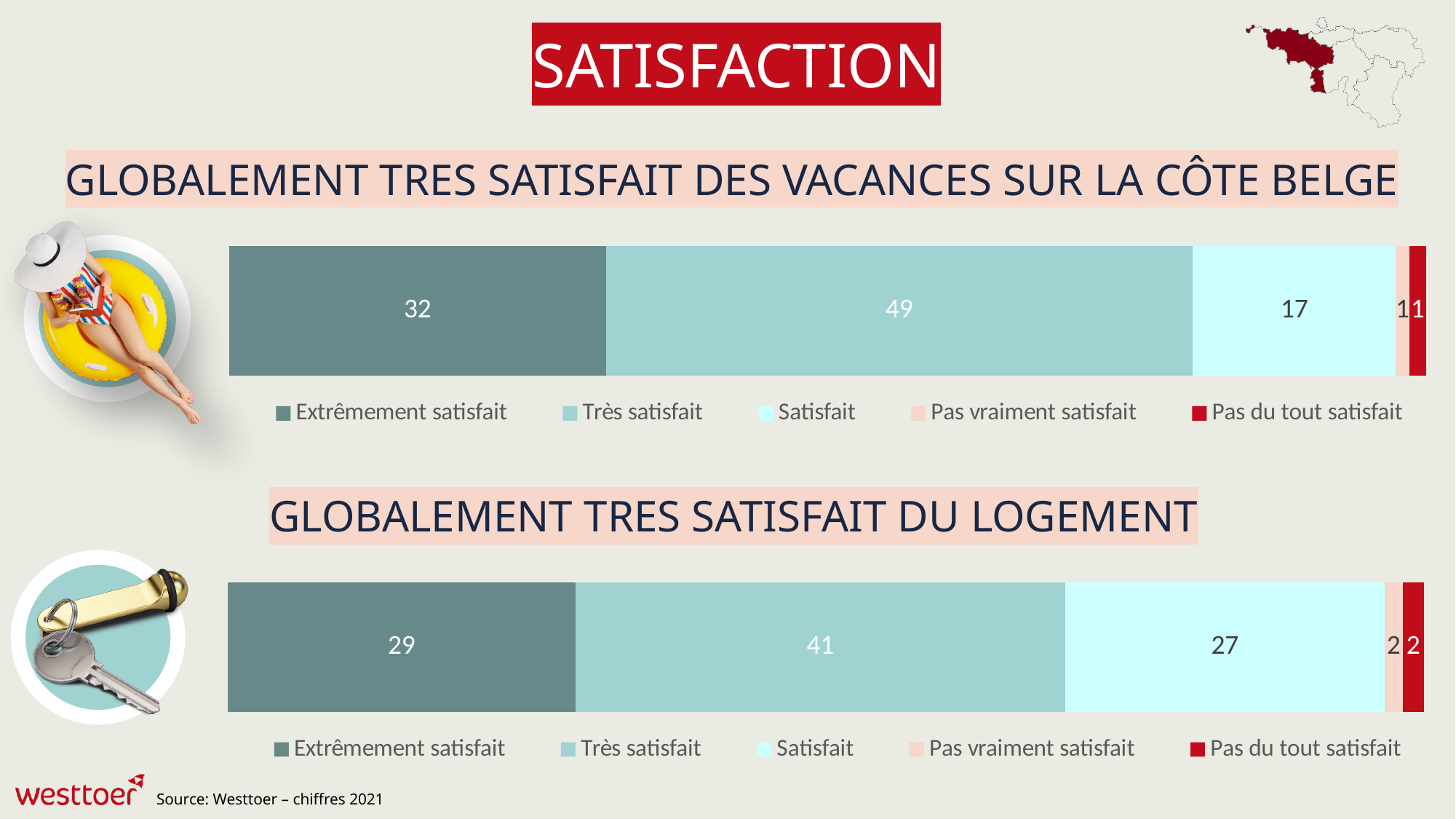
In the bottom chart (logement), what is the difference between Très satisfait and Satisfait? 14 In the bottom chart (logement), which category has the highest value? Très satisfait In the top chart (vacances sur la côte belge), what is the value for Extrêmement satisfait? 32 In the bottom chart (logement), what is the value for Satisfait? 27 In the top chart (vacances sur la côte belge), what is the difference between Très satisfait and Extrêmement satisfait? 17 How many series does the legend of the top chart (vacances sur la côte belge) list? 5 What kind of chart is the bottom chart (logement)? Stacked bar chart What is the total of the stacked bar in the top chart (vacances sur la côte belge)? 100 Which is larger in the bottom chart (logement): Extrêmement satisfait or Satisfait? Extrêmement satisfait In the bottom chart (logement), what is the value for Très satisfait? 41 In the top chart (vacances sur la côte belge), which category has the highest value? Très satisfait In the top chart (vacances sur la côte belge), what is the value for Très satisfait? 49